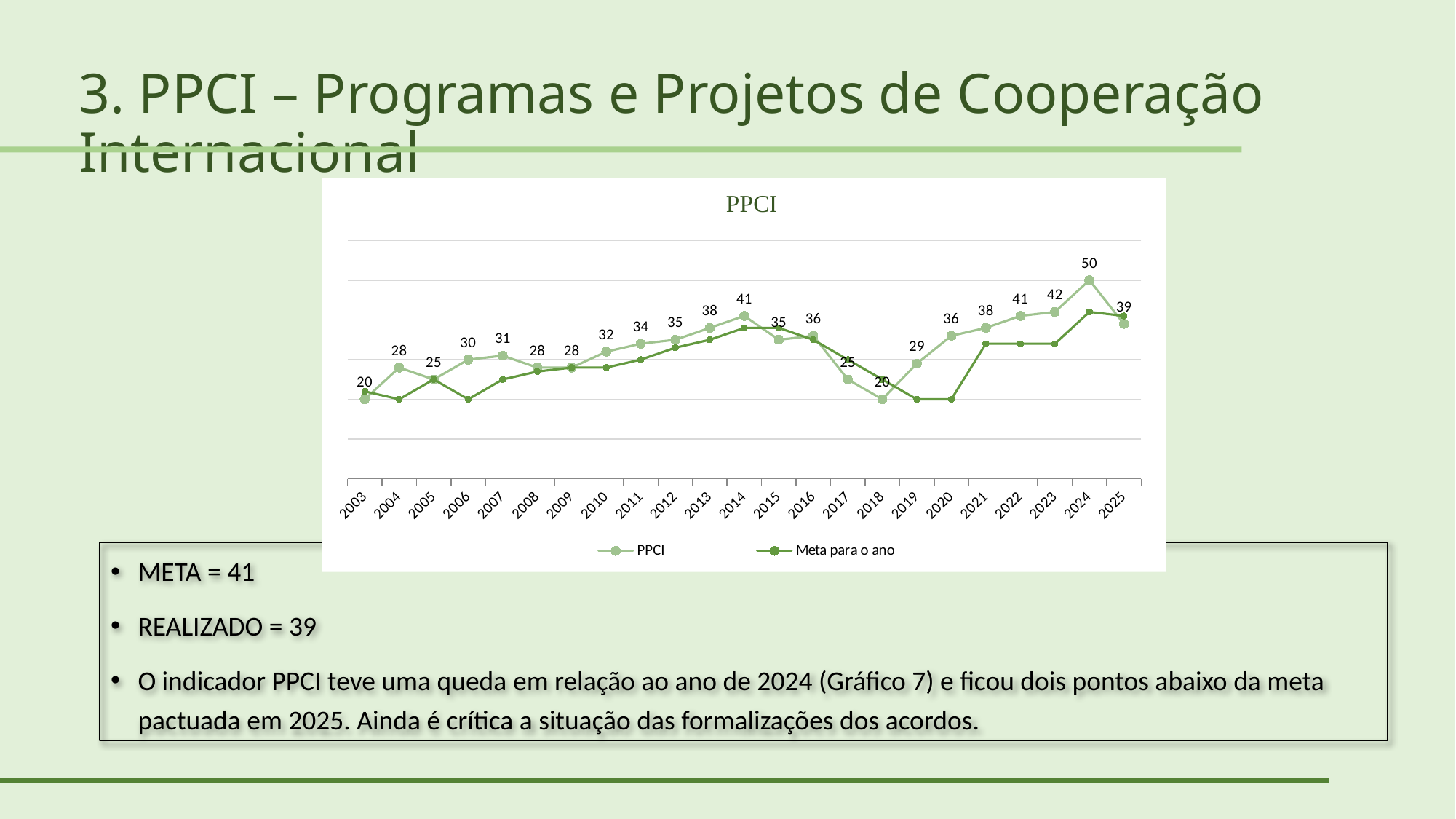
In which year does the PPCI series reach its highest value? 2024 What is the PPCI value for 2014? 41 What is the difference between the PPCI values for 2023 and 2022? 1 Which year has the larger PPCI value, 2017 or 2019? 2019 What type of chart is shown on the slide? line chart Does the PPCI series rise or fall from 2018 to 2024? rise What is the title of the chart? PPCI What is the PPCI value for 2025? 39 How many years are plotted along the x axis of the chart? 23 What is the PPCI value for 2024? 50 How many series does the chart legend list? 2 What is the difference between the PPCI values for 2024 and 2025? 11